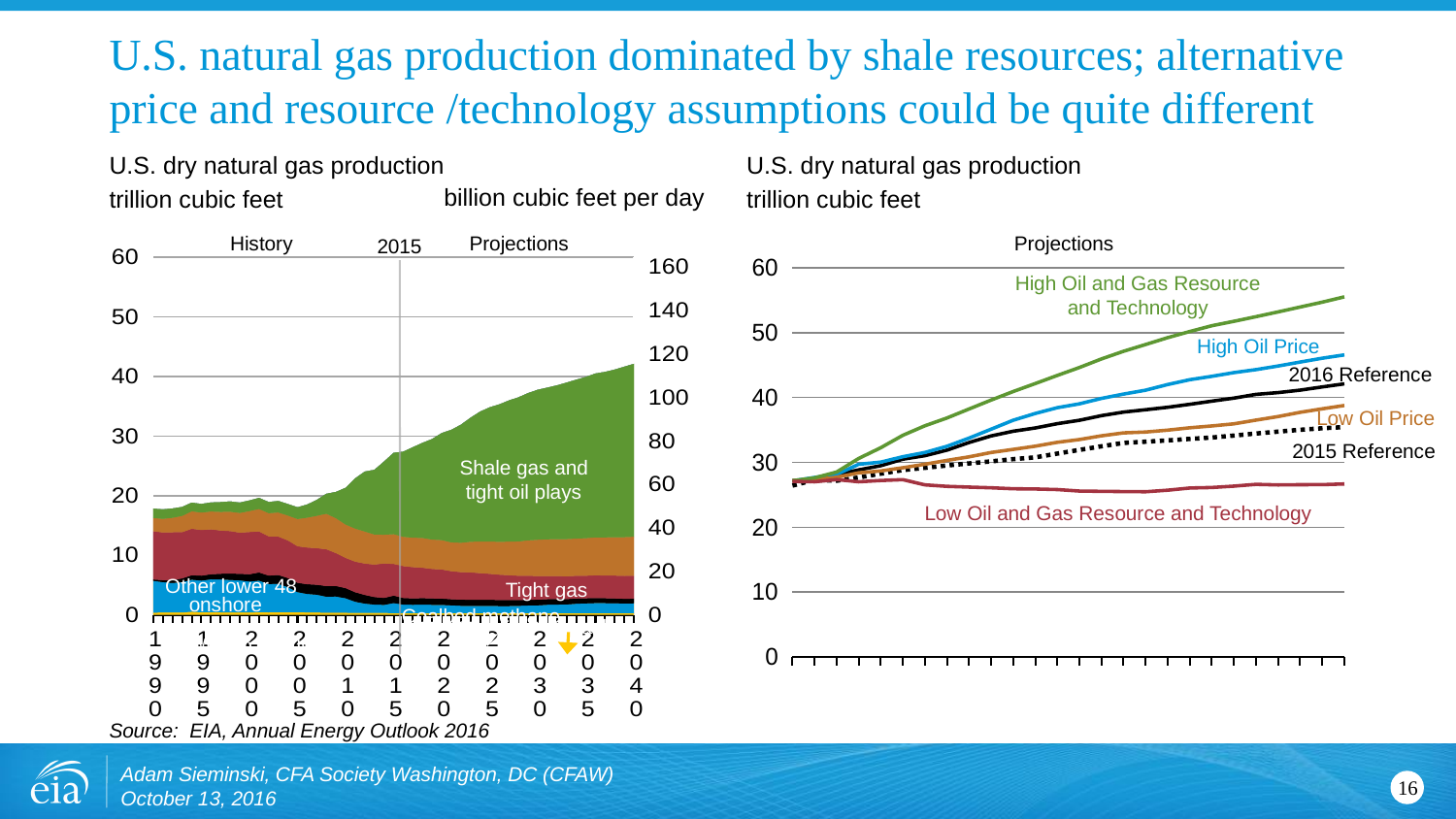
In the left chart, is total U.S. dry natural gas production in 1990 greater or less than 20 trillion cubic feet? less In the left chart, is total U.S. dry natural gas production in 2040 greater or less than 40 trillion cubic feet? greater What kind of chart is the left chart, 'U.S. dry natural gas production' with History and Projections? stacked area chart In the right chart, which scenario has the highest production at the end of the projection period? High Oil and Gas Resource and Technology What kind of chart is the right chart, 'U.S. dry natural gas production' showing Projections? line chart In the left chart, what unit is shown on the right-hand vertical axis? billion cubic feet per day In the right chart, which scenario has the lowest production at the end of the projection period? Low Oil and Gas Resource and Technology In the right chart, is the Low Oil and Gas Resource and Technology value at the end of the projection greater or less than 30? less In the left chart, what year does the vertical line separating History from Projections mark? 2015 In the left chart, which series makes up the largest share of production in 2040? Shale gas and tight oil plays In the right chart, how many scenario lines are plotted? 6